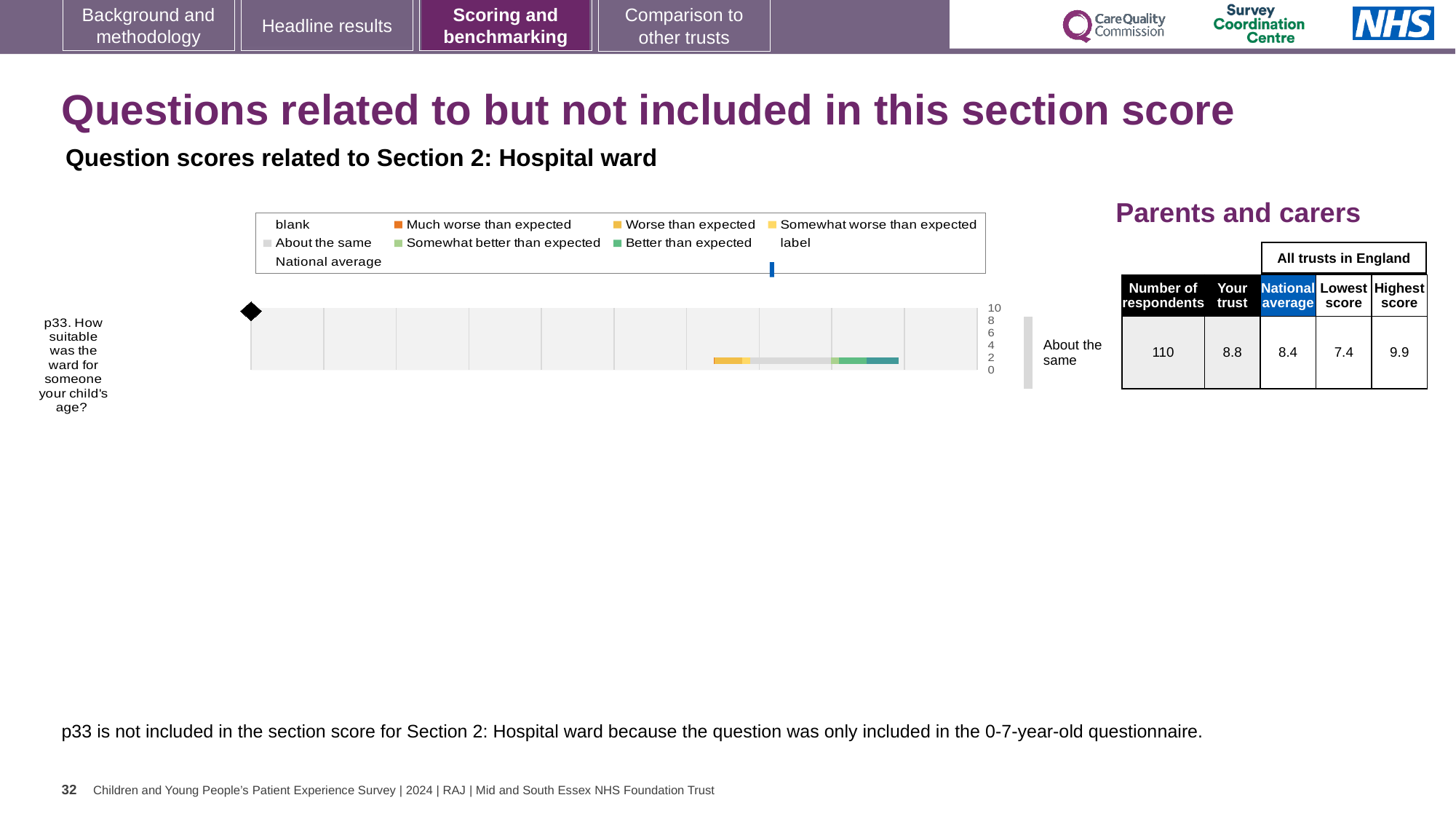
What is the difference between the 'Your trust' score and the national average for p33? 0.4 In the table beside the chart, what is the lowest score among all trusts in England for p33? 7.4 Which question is plotted in the chart? p33. How suitable was the ward for someone your child's age? How many respondents answered p33 according to the table beside the chart? 110 Which is larger for p33, the 'Your trust' score or the national average? Your trust What benchmark category is shown for p33 next to the chart? About the same In the table beside the chart, what is the highest score among all trusts in England for p33? 9.9 In the table beside the chart, what is the 'Your trust' score for p33? 8.8 What kind of chart is used to show the p33 question score? Bar chart In the table beside the chart, what is the national average score for p33? 8.4 What is the difference between the highest and lowest scores among all trusts in England for p33? 2.5 How many questions are plotted in the chart? 1